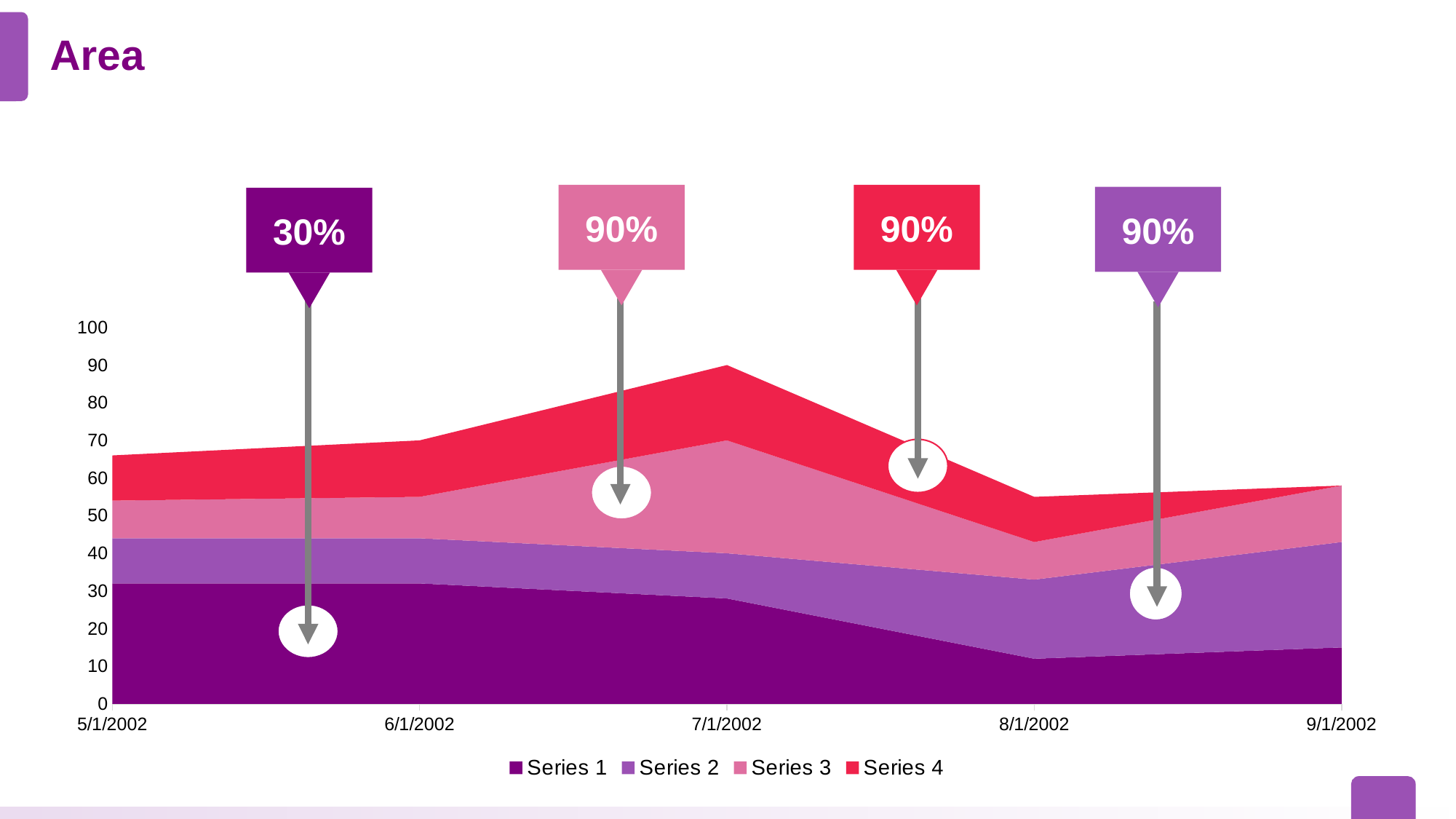
Which series is plotted at the bottom of the stack? Series 1 Is the value for Series 1 at 5/1/2002 greater or less than 20? greater Which is larger for Series 1: the value at 5/1/2002 or at 9/1/2002? 5/1/2002 What kind of chart is shown on the slide? area chart Is the value for Series 1 at 8/1/2002 greater or less than 20? less How many dates are labelled on the x axis? 5 Is the top of the stacked area at 7/1/2002 greater or less than 80? greater How many series does the legend list? 4 Does the stacked total rise or fall from 6/1/2002 to 7/1/2002? rise What is the title of the slide? Area Does the value for Series 1 rise or fall from 7/1/2002 to 8/1/2002? fall At which date does the stacked area reach its highest total? 7/1/2002